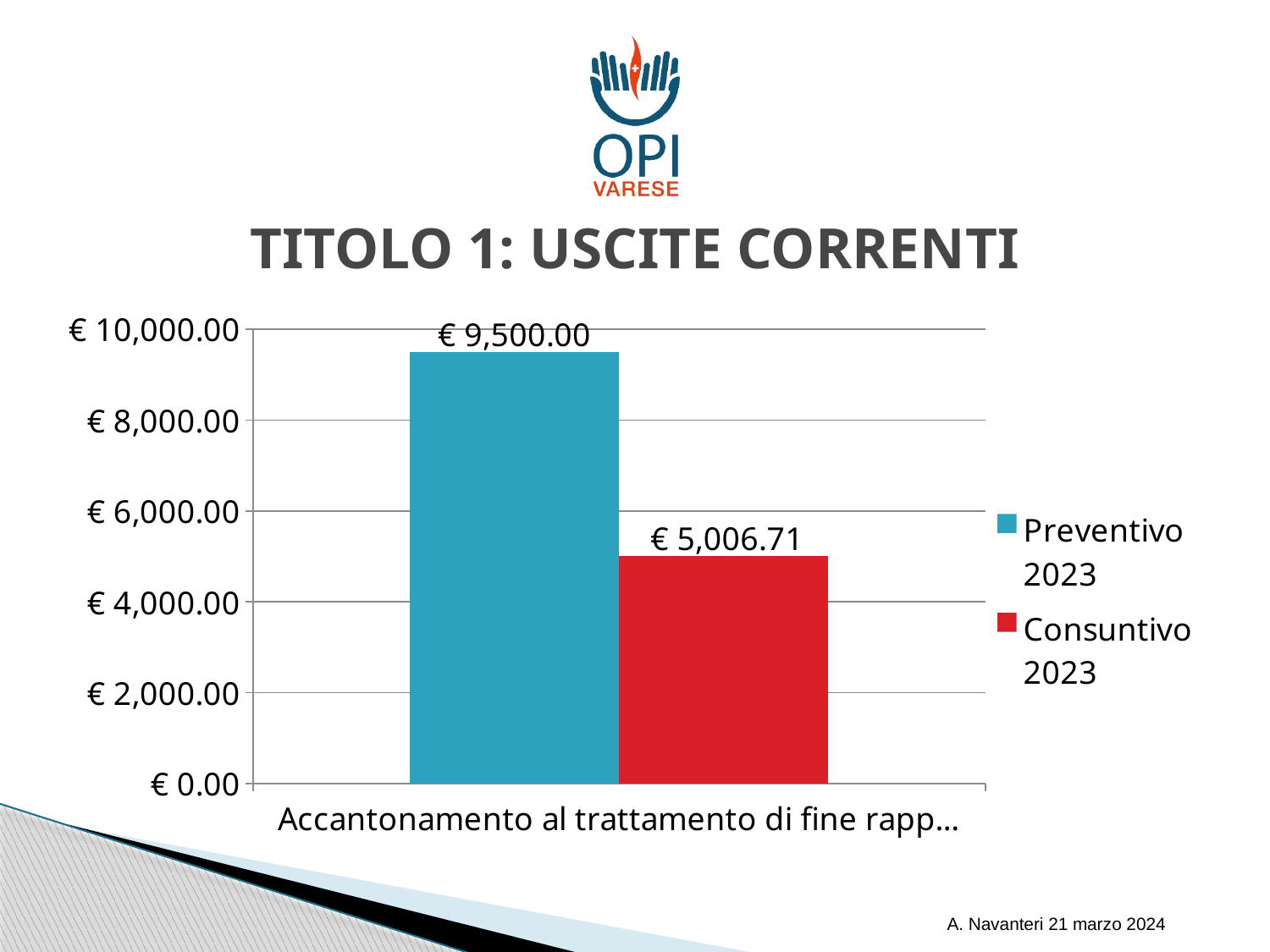
What colour is the bar for Consuntivo 2023? Red What is the value for Preventivo 2023? € 9,500.00 How many series does the legend list? 2 What is the value for Consuntivo 2023? € 5,006.71 What kind of chart is shown on the slide? Bar chart What is the title of the slide above the chart? TITOLO 1: USCITE CORRENTI What is the difference between the Preventivo 2023 and Consuntivo 2023 values? € 4,493.29 Is the value for Consuntivo 2023 greater or less than € 6,000.00? less Which series has the higher value, Preventivo 2023 or Consuntivo 2023? Preventivo 2023 Which series has the lowest value? Consuntivo 2023 How many categories are shown on the x axis? 1 Is the value for Preventivo 2023 greater or less than € 8,000.00? greater